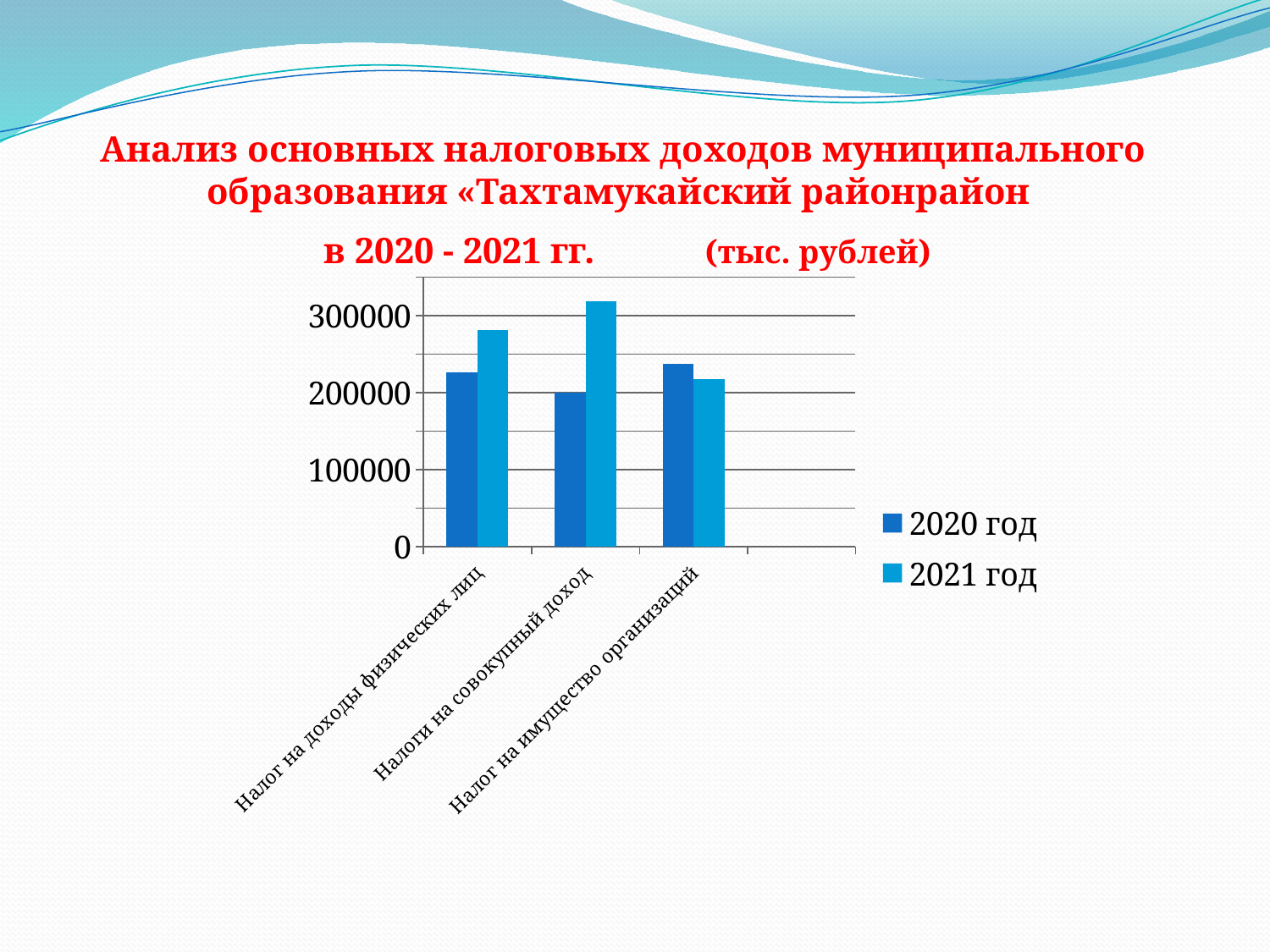
Which series has the higher value for «Налоги на совокупный доход», 2020 год or 2021 год? 2021 год What unit of measurement is stated in the chart title? тыс. рублей Which category has the highest value in the 2021 год series? Налоги на совокупный доход Which series has the higher value for «Налог на имущество организаций», 2020 год or 2021 год? 2020 год Which category has the lowest value in the 2021 год series? Налог на имущество организаций How many series does the legend list? 2 Which series has the higher value for «Налог на доходы физических лиц», 2020 год or 2021 год? 2021 год How many tax categories are shown on the x axis? 3 Is the 2021 год value for «Налоги на совокупный доход» greater or less than 300000? greater Which category has the lowest value in the 2020 год series? Налоги на совокупный доход Is the 2020 год value for «Налог на имущество организаций» greater or less than 300000? less What kind of chart is shown on the slide? bar chart